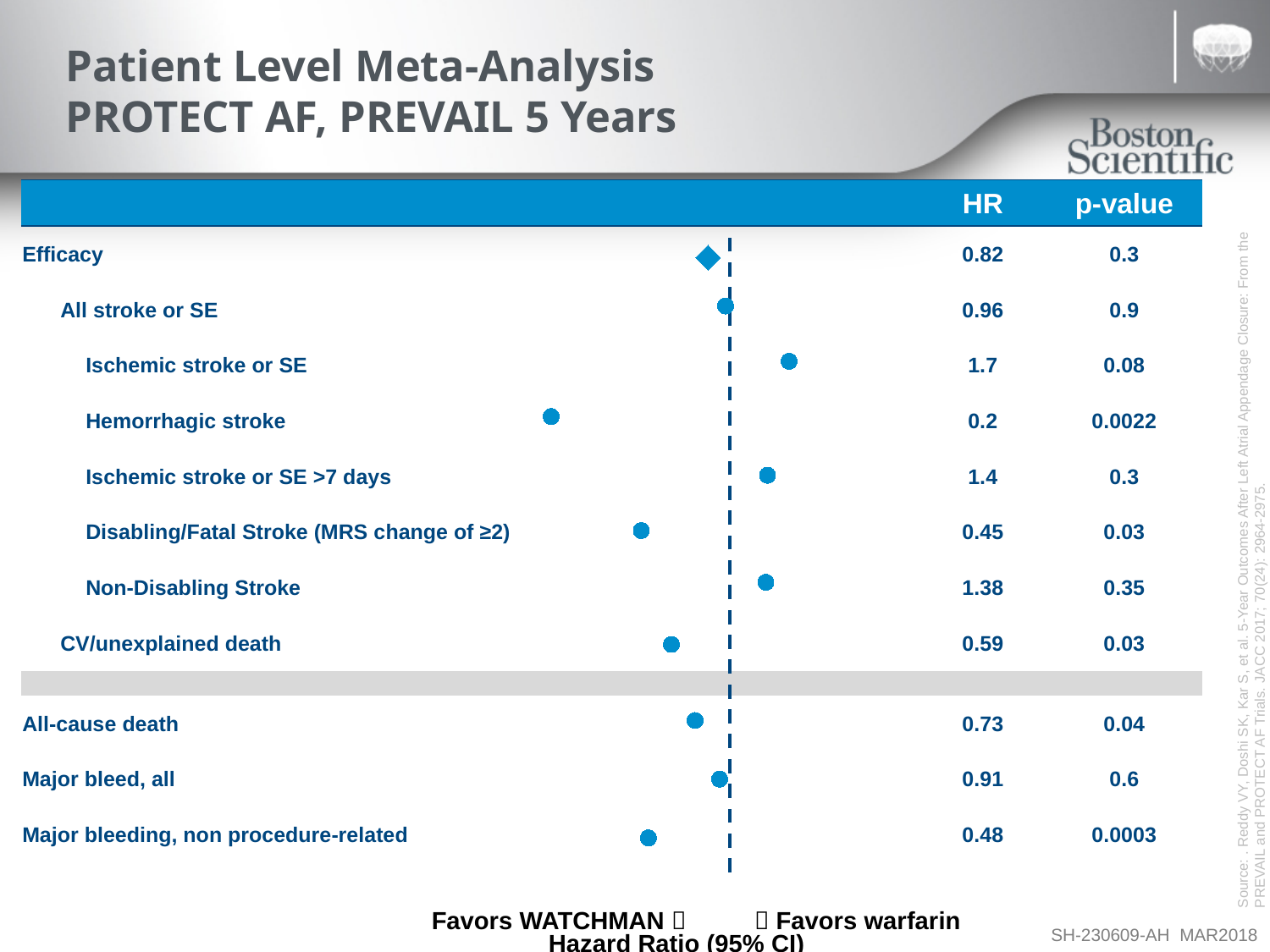
Which outcome has the lowest hazard ratio? Hemorrhagic stroke What is the hazard ratio (HR) for Hemorrhagic stroke? 0.2 What is the label of the horizontal axis of the chart? Hazard Ratio (95% CI) Which outcome has the highest hazard ratio? Ischemic stroke or SE What is the difference between the HR for Ischemic stroke or SE and the HR for Hemorrhagic stroke? 1.5 How many outcomes are plotted on the chart? 11 Is the HR for Disabling/Fatal Stroke (MRS change of ≥2) greater or less than 1? less Which has the larger HR: All-cause death or Major bleed, all? Major bleed, all What is the p-value for Major bleeding, non procedure-related? 0.0003 What is the p-value for Ischemic stroke or SE? 0.08 What is the HR for All-cause death? 0.73 What kind of chart is shown on the slide? Forest plot (dot plot of hazard ratios)